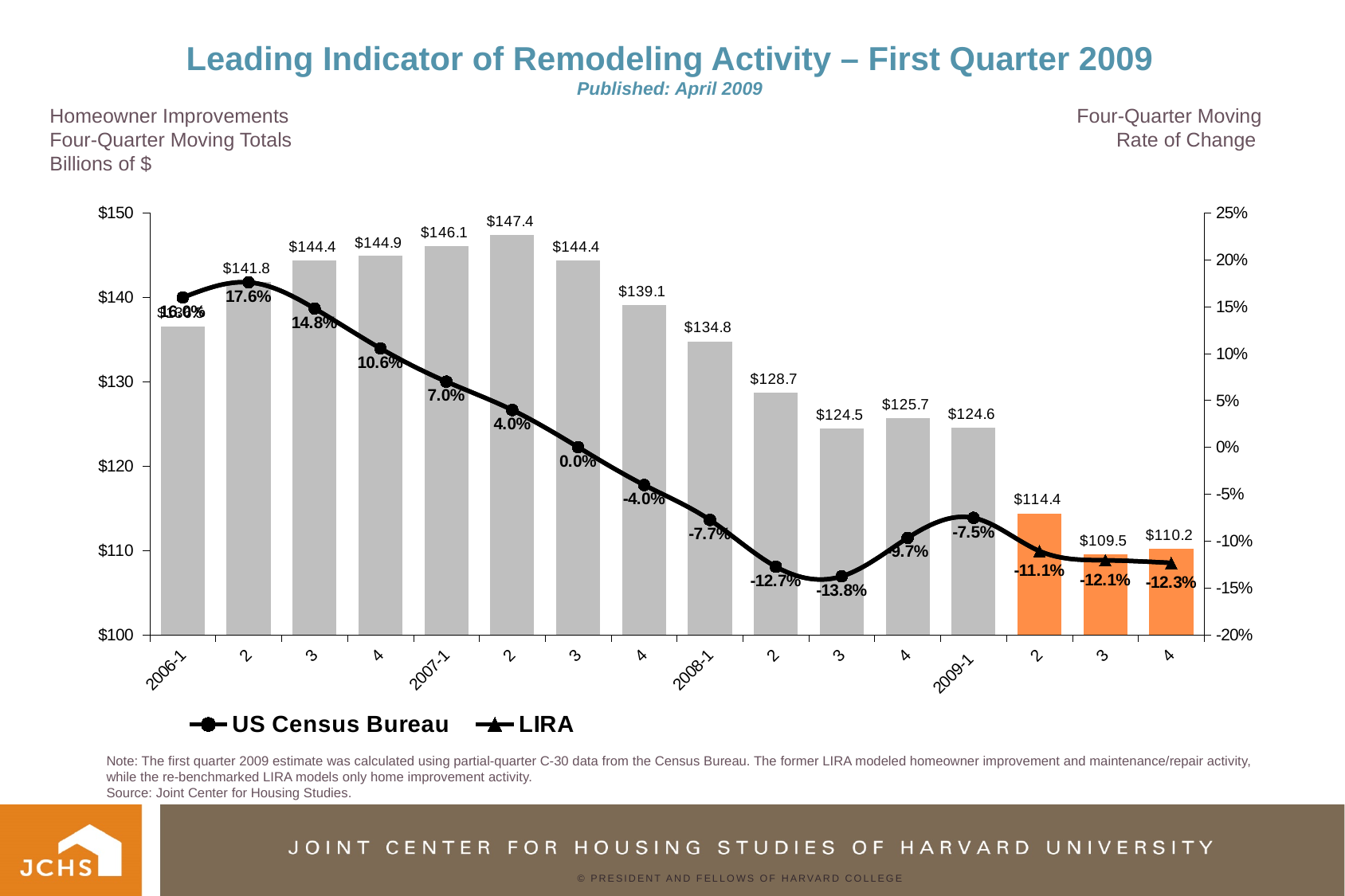
How many quarters are shown on the x axis? 16 Which quarter has the highest four-quarter moving total? 2007-2 Which is larger, the four-quarter moving total for 2008-4 or for 2009-1? 2008-4 What is the four-quarter moving total for 2009-2? $114.4 What is the four-quarter moving rate of change for 2008-3? -13.8% Which quarter has the lowest four-quarter moving rate of change? 2008-3 What is the four-quarter moving total for 2007-2? $147.4 What is the difference between the four-quarter moving totals for 2007-2 and 2009-3? $37.9 What kind of chart is used for the four-quarter moving totals? Bar chart Does the four-quarter moving rate of change rise or fall from 2006-2 to 2008-3? Fall Which quarter has the lowest four-quarter moving total? 2009-3 How many series does the legend list? 2